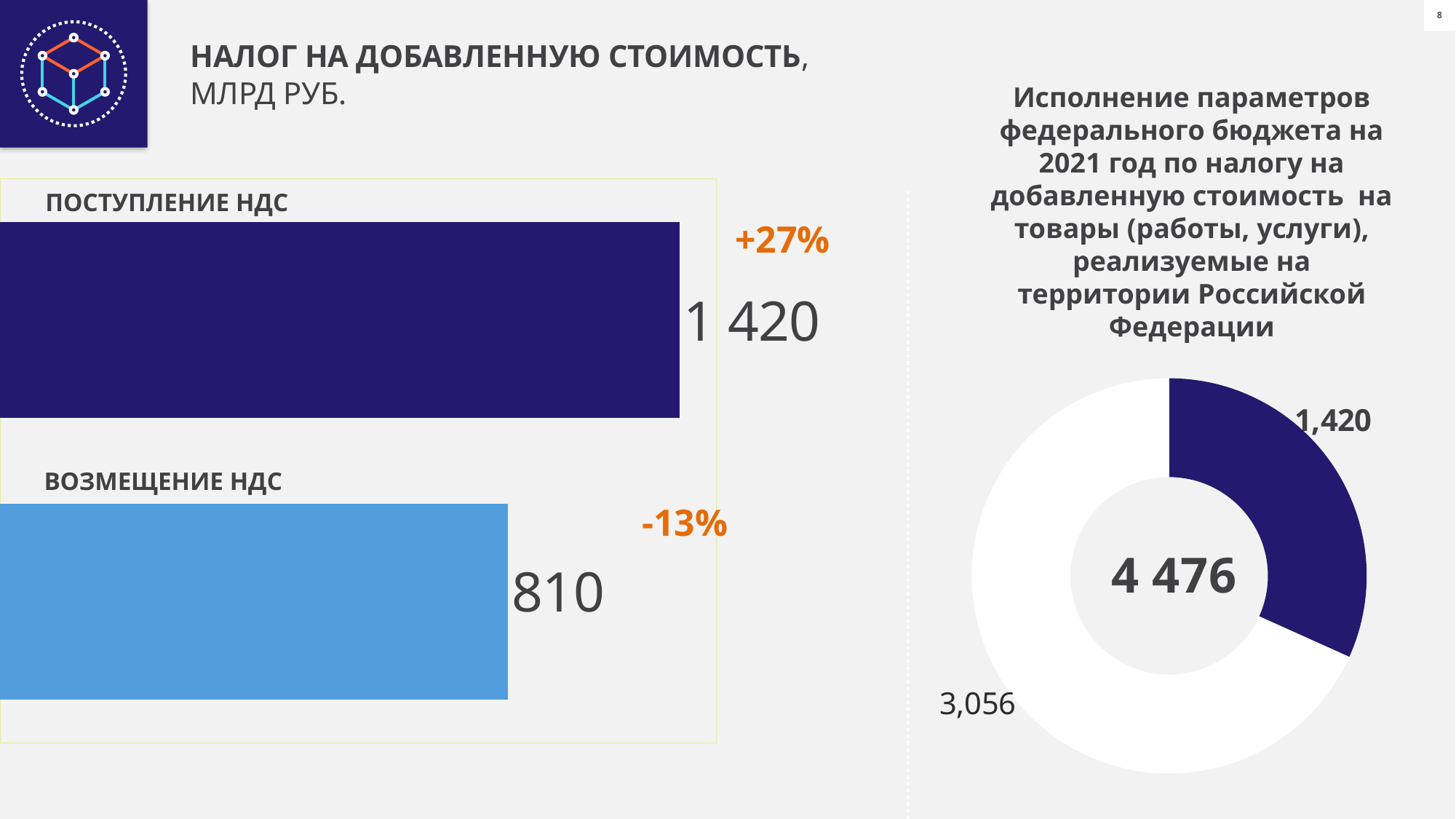
In the bar chart on the left, what percentage change is shown next to ПОСТУПЛЕНИЕ НДС? +27% In the bar chart on the left, which category has the higher value? ПОСТУПЛЕНИЕ НДС In the donut chart on the right, what is the value of the larger (white) segment? 3,056 In the donut chart on the right, what total value is shown in the centre? 4 476 How many categories does the bar chart on the left show? 2 What kind of chart is shown on the left side of the slide? bar chart In the bar chart on the left, what is the value for ВОЗМЕЩЕНИЕ НДС? 810 In the bar chart on the left, what percentage change is shown next to ВОЗМЕЩЕНИЕ НДС? -13% In the bar chart on the left, what is the value for ПОСТУПЛЕНИЕ НДС? 1 420 What kind of chart is shown on the right side of the slide? donut chart In the bar chart on the left, what is the difference between ПОСТУПЛЕНИЕ НДС and ВОЗМЕЩЕНИЕ НДС? 610 In the bar chart on the left, which category has the lower value? ВОЗМЕЩЕНИЕ НДС